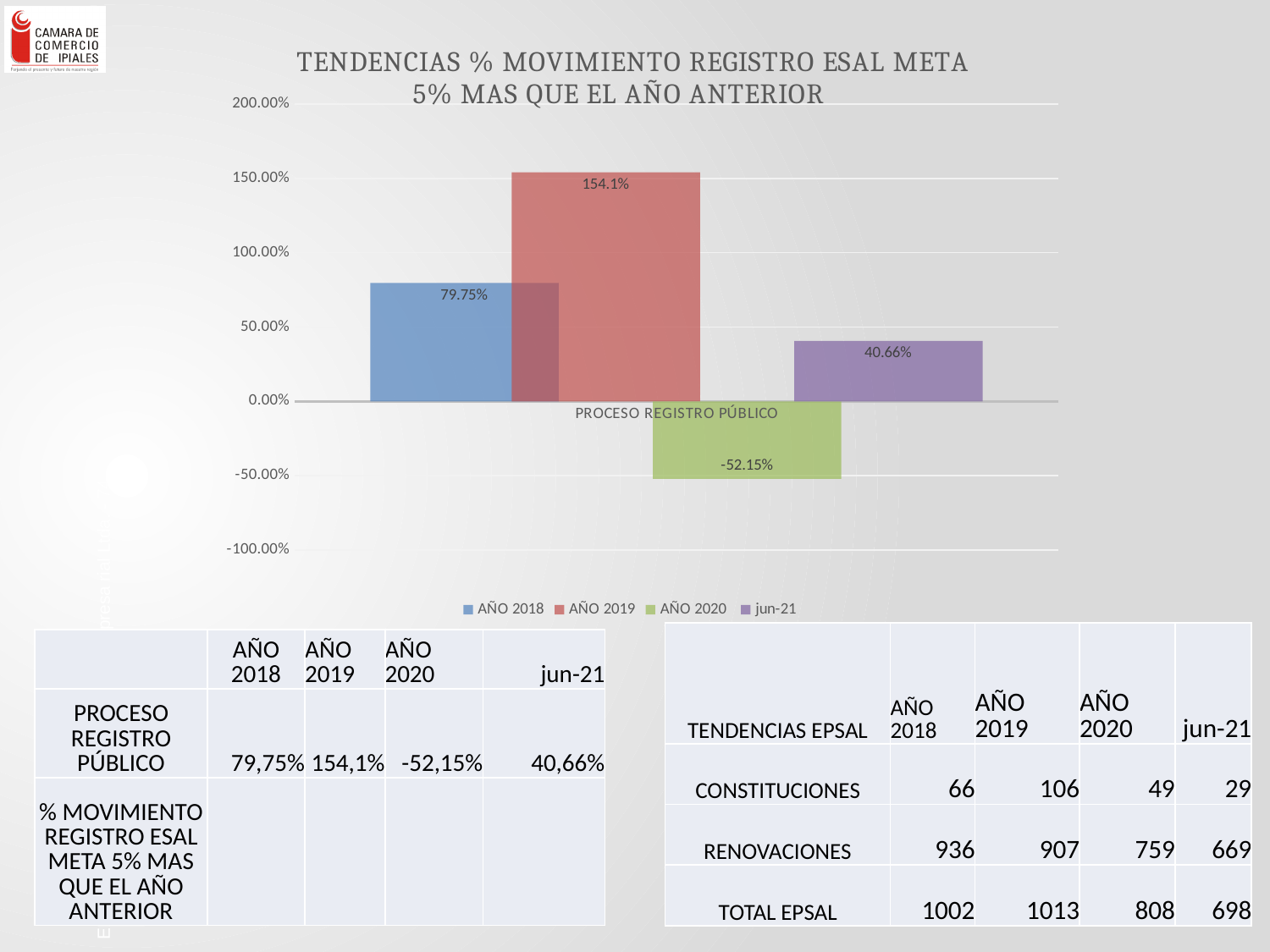
What is the value of the AÑO 2020 bar for PROCESO REGISTRO PÚBLICO? -52.15% Is the value for AÑO 2019 greater or less than 150.00%? greater Which series has the highest value in the chart? AÑO 2019 What is the value of the jun-21 bar for PROCESO REGISTRO PÚBLICO? 40.66% How many series does the legend list? 4 Which series has the lowest value in the chart? AÑO 2020 What kind of chart is shown on the slide? Bar chart What is the value of the AÑO 2019 bar for PROCESO REGISTRO PÚBLICO? 154.1% What is the value of the AÑO 2018 bar for PROCESO REGISTRO PÚBLICO? 79.75% What is the difference between the AÑO 2019 value and the AÑO 2018 value? 74.35% Which is larger, the AÑO 2018 value or the jun-21 value? AÑO 2018 What is the title of the chart? TENDENCIAS % MOVIMIENTO REGISTRO ESAL META 5% MAS QUE EL AÑO ANTERIOR